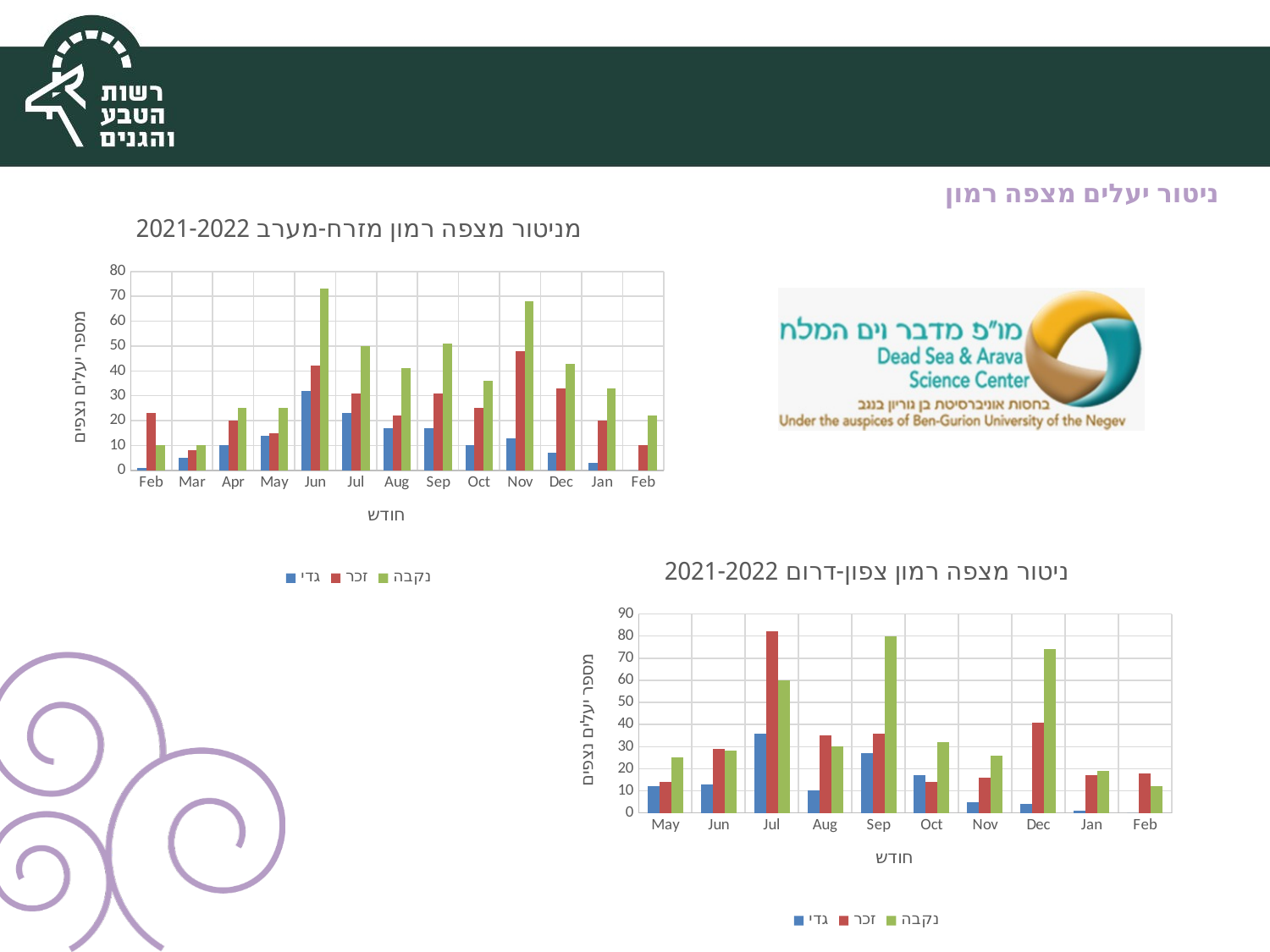
In the chart titled 'ניטור מצפה רמון צפון-דרום 2021-2022', which series has the tallest bar in Jul? זכר How many months are shown on the x axis of the chart titled 'ניטור מצפה רמון צפון-דרום 2021-2022'? 10 In the chart titled 'מניטור מצפה רמון מזרח-מערב 2021-2022', is the נקבה value for Jun greater or less than 70? greater In the chart titled 'מניטור מצפה רמון מזרח-מערב 2021-2022', which is larger for Jun: זכר or נקבה? נקבה In the chart titled 'ניטור מצפה רמון צפון-דרום 2021-2022', which is larger for Sep: זכר or נקבה? נקבה How many series does the legend of the chart titled 'ניטור מצפה רמון צפון-דרום 2021-2022' list? 3 How many months are shown on the x axis of the chart titled 'מניטור מצפה רמון מזרח-מערב 2021-2022'? 13 What type of chart is the chart titled 'מניטור מצפה רמון מזרח-מערב 2021-2022'? bar chart In the chart titled 'מניטור מצפה רמון מזרח-מערב 2021-2022', which month has the highest נקבה bar? Jun In the chart titled 'מניטור מצפה רמון מזרח-מערב 2021-2022', is the נקבה value for Nov greater or less than 60? greater In the chart titled 'ניטור מצפה רמון צפון-דרום 2021-2022', what colour represents the גדי series? blue In the chart titled 'ניטור מצפה רמון צפון-דרום 2021-2022', is the זכר value for Jul greater or less than 70? greater